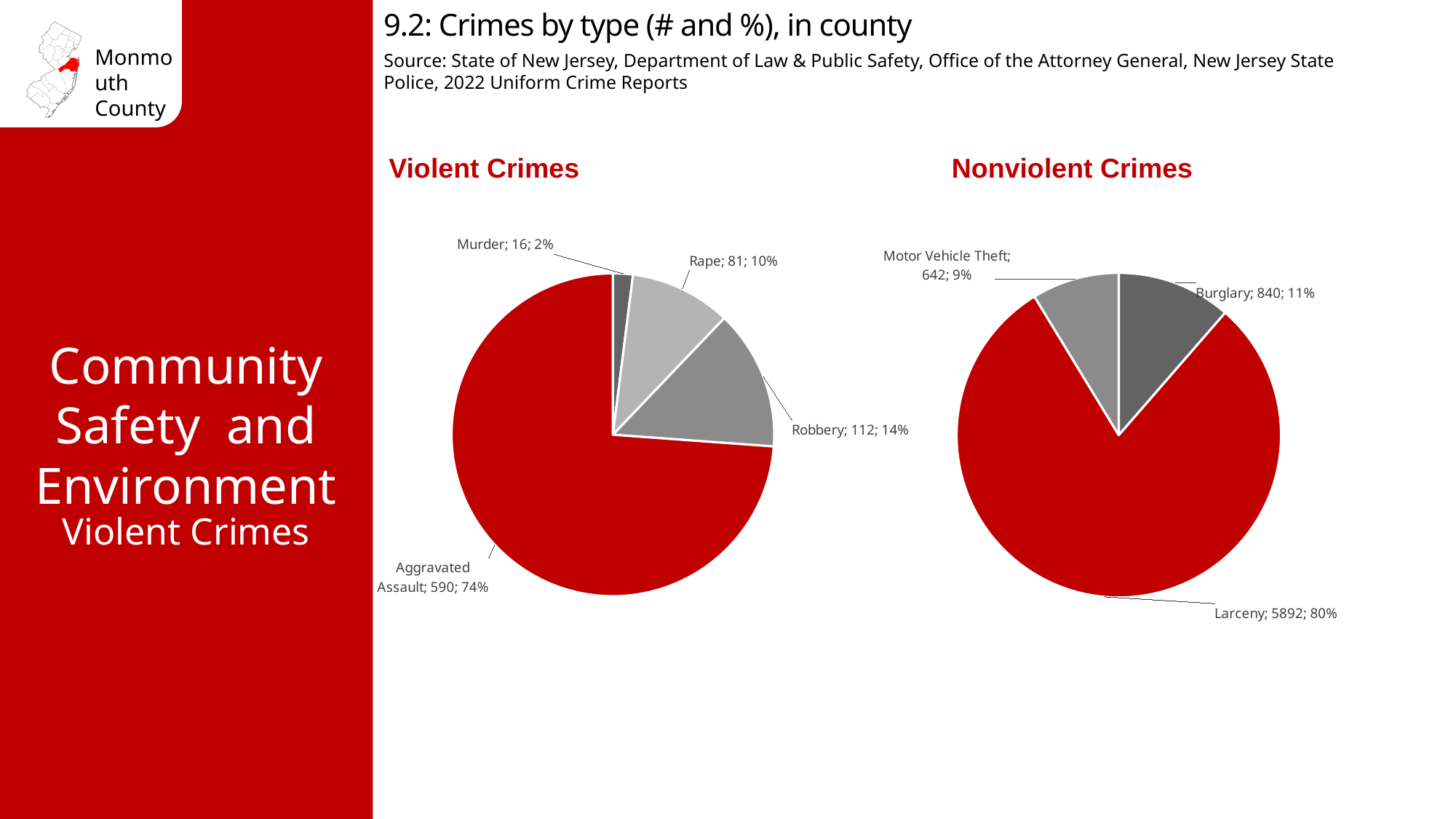
In the Nonviolent Crimes chart, how many larcenies are shown? 5892 In the Violent Crimes chart, how many categories are shown? 4 In the Violent Crimes chart, what is the difference between the number of robberies and the number of rapes? 31 In the Nonviolent Crimes chart, how many categories are shown? 3 In the Violent Crimes chart, what share of the pie is Robbery? 14% In the Violent Crimes chart, which category has the largest slice? Aggravated Assault In the Violent Crimes chart, which category has the smallest slice? Murder What kind of chart is the Nonviolent Crimes chart? Pie chart In the Nonviolent Crimes chart, what is the difference between the number of burglaries and motor vehicle thefts? 198 In the Nonviolent Crimes chart, what share of the pie is Motor Vehicle Theft? 9% In the Violent Crimes chart, how many aggravated assaults are shown? 590 In the Nonviolent Crimes chart, which is larger, Burglary or Motor Vehicle Theft? Burglary